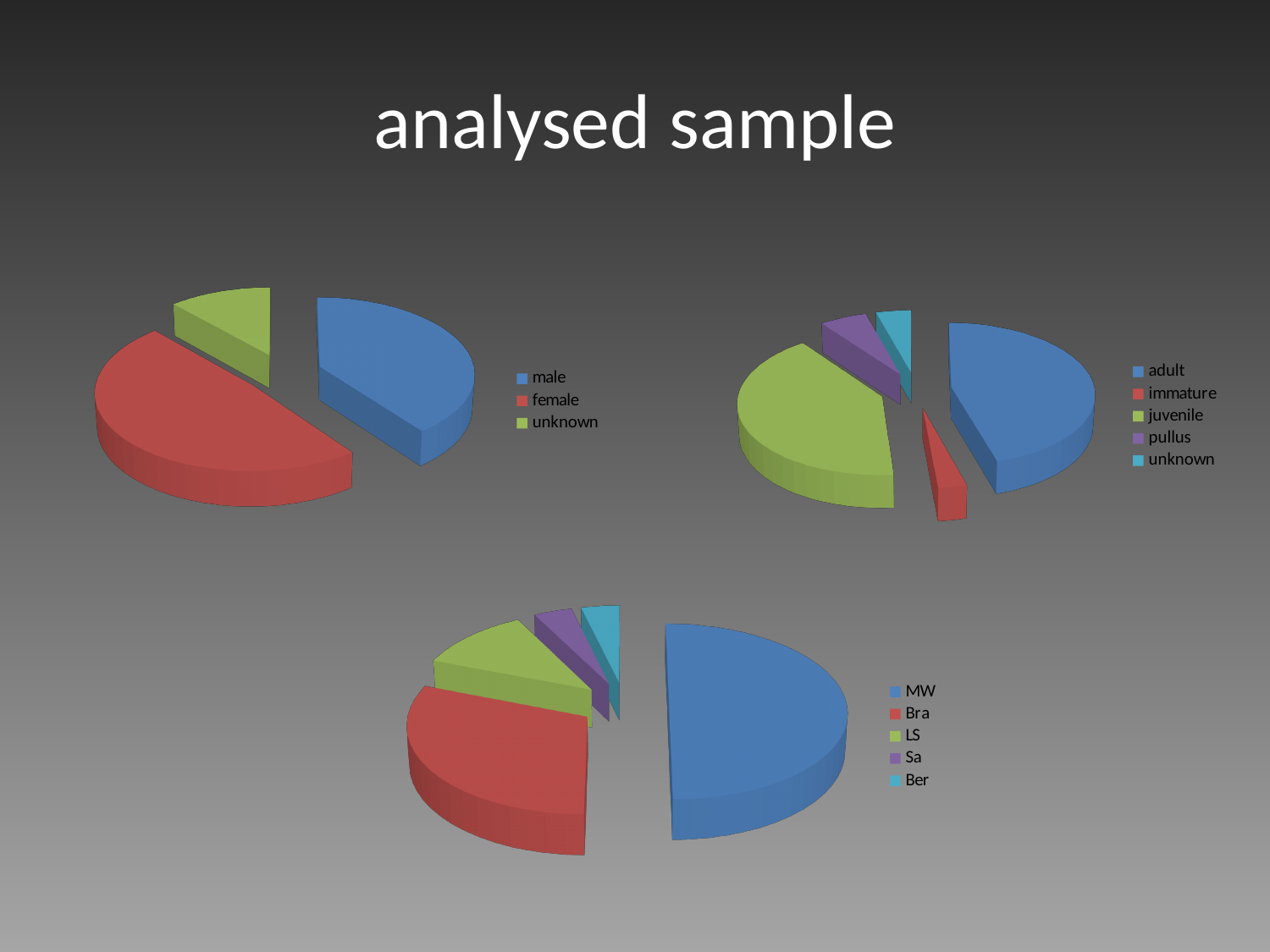
What kind of chart is the top-left chart with the male/female/unknown legend? pie chart What is the title of the slide? analysed sample How many categories does the top-left pie chart (male/female/unknown) show? 3 In the bottom pie chart (MW/Bra/LS/Sa/Ber), which category has the largest slice? MW In the top-right pie chart (adult/immature/juvenile/pullus/unknown), which category has the largest slice? adult In the top-left pie chart, is the slice for male larger or smaller than the slice for female? smaller In the top-left pie chart (male/female/unknown), which category has the smallest slice? unknown In the top-right pie chart, is the slice for adult larger or smaller than the slice for immature? larger How many pie charts are shown on the slide? 3 In the bottom pie chart, is the slice for Bra larger or smaller than the slice for LS? larger In the top-left pie chart (male/female/unknown), which category has the largest slice? female How many categories does the top-right pie chart (adult/immature/juvenile/pullus/unknown) show? 5